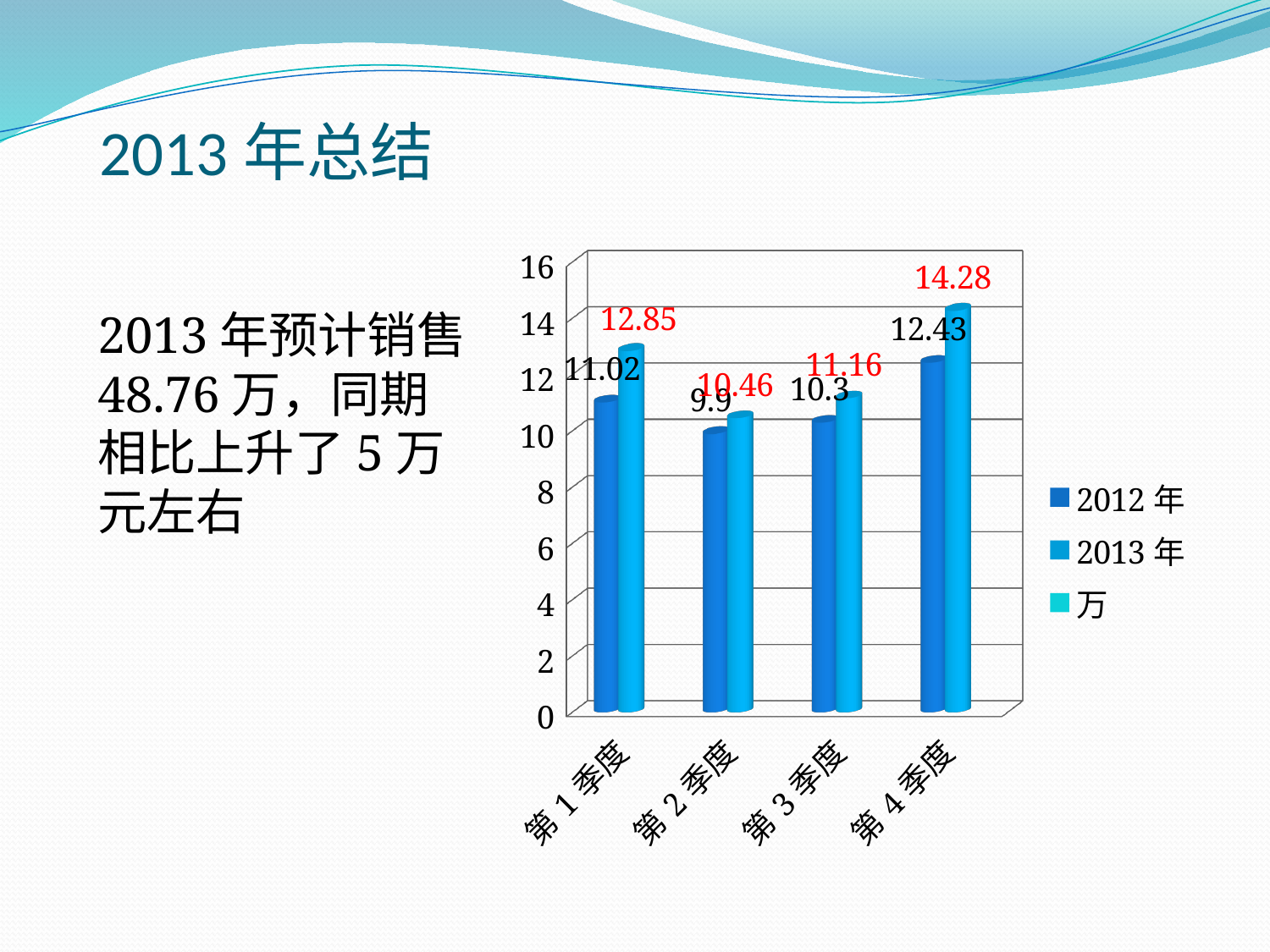
Which quarter has the lowest value in the 2012年 series? 第2季度 What is the value for 第3季度 in the 2013年 series? 11.16 What is the value for 第1季度 in the 2012年 series? 11.02 What is the value for 第4季度 in the 2013年 series? 14.28 How many quarters are shown on the x axis? 4 How many entries does the legend list? 3 Which quarter has the highest value in the 2013年 series? 第4季度 Which is larger for 第2季度: the 2012年 value or the 2013年 value? 2013年 What is the value for 第2季度 in the 2012年 series? 9.9 What is the difference between the 2013年 and 2012年 values for 第4季度? 1.85 What kind of chart is shown on the slide? bar chart Is the 2013年 value for 第1季度 greater or less than 12? greater